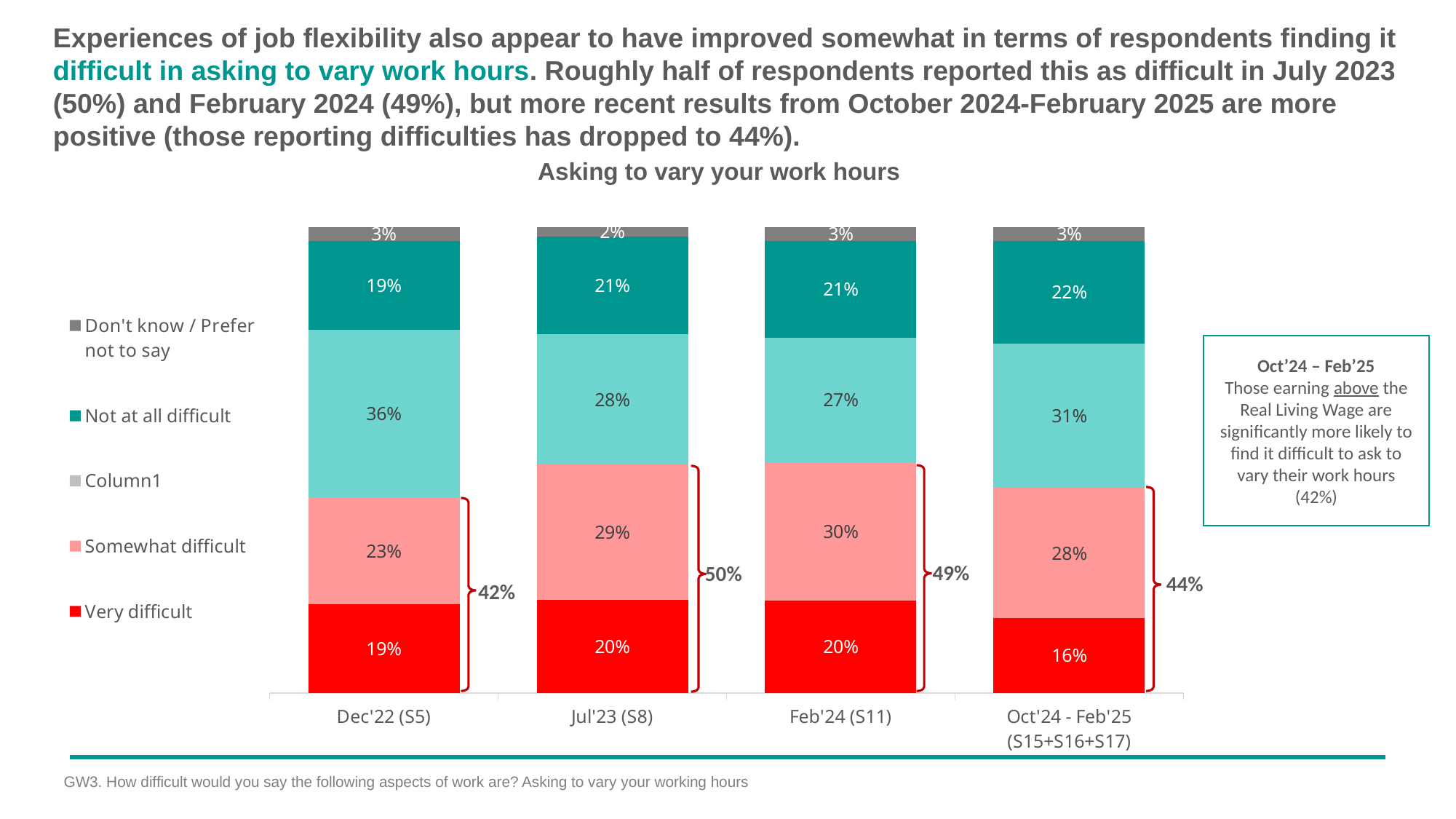
Which time period has the highest 'Not at all difficult' percentage? Oct'24 - Feb'25 (S15+S16+S17) What is the 'Don't know / Prefer not to say' value for Jul'23 (S8)? 2% What type of chart is shown on the slide? Stacked bar chart What is the difference between the 'Somewhat difficult' values for Jul'23 (S8) and Dec'22 (S5)? 6% What percentage of respondents said 'Very difficult' in Dec'22 (S5)? 19% How many time periods (bars) are shown on the x axis? 4 What is the title of the chart? Asking to vary your work hours What percentage of respondents said 'Not at all difficult' in Oct'24 - Feb'25 (S15+S16+S17)? 22% What is the combined 'Very difficult' and 'Somewhat difficult' share shown by the bracket for Feb'24 (S11)? 49% What percentage of respondents said 'Somewhat difficult' in Feb'24 (S11)? 30% How many series does the legend list? 5 Which time period has the lowest 'Very difficult' percentage? Oct'24 - Feb'25 (S15+S16+S17)